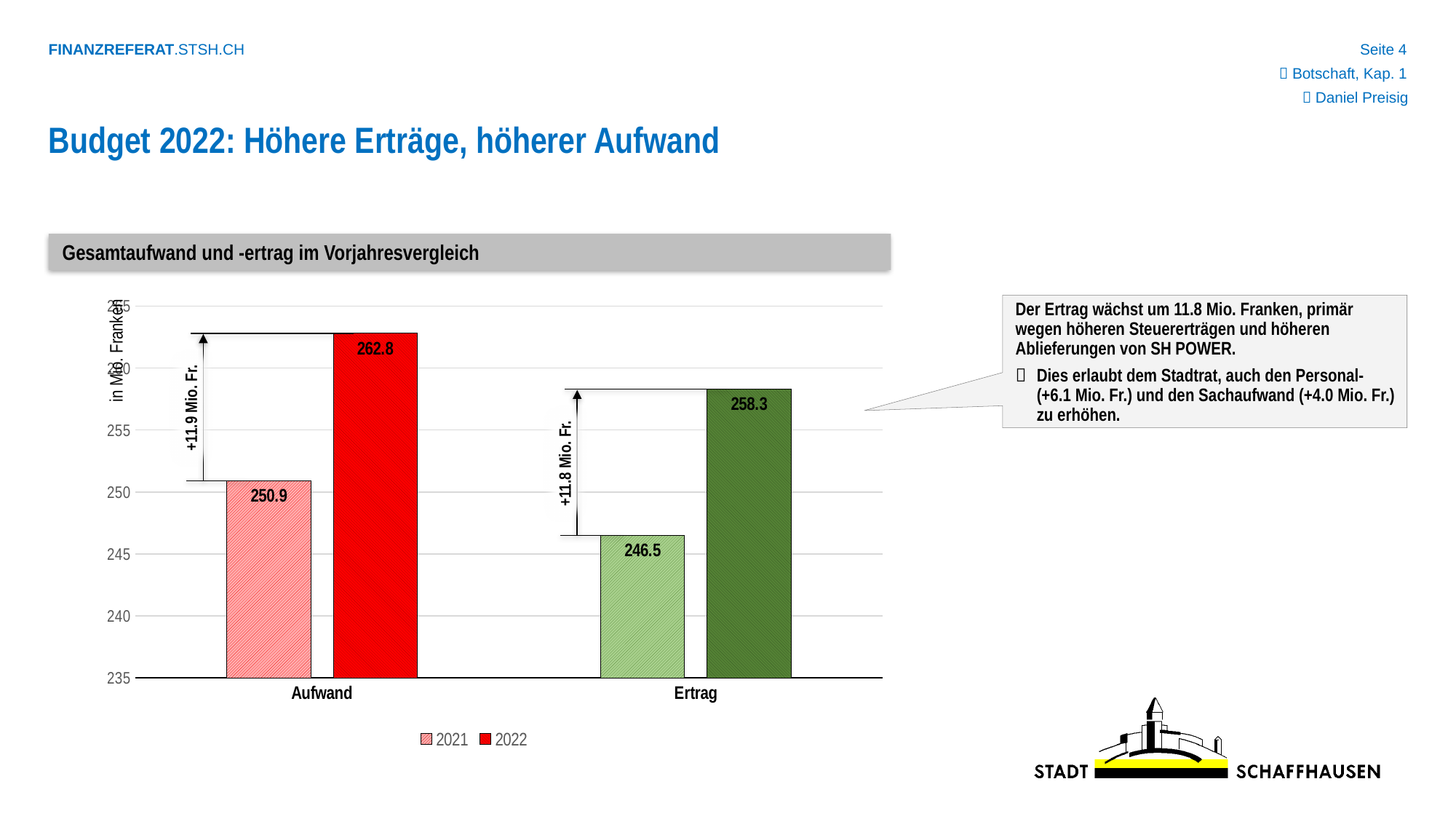
Which is larger, Aufwand 2022 or Ertrag 2022? Aufwand 2022 What is the difference between Ertrag 2022 and Ertrag 2021? 11.8 How many series does the legend list? 2 What is the difference between Aufwand 2022 and Aufwand 2021? 11.9 Which bar has the lowest value in the chart? Ertrag 2021 What kind of chart is shown on the slide? Bar chart What is the title of the chart? Gesamtaufwand und -ertrag im Vorjahresvergleich What is the value for Ertrag in 2021? 246.5 What is the value for Ertrag in 2022? 258.3 Which bar has the highest value in the chart? Aufwand 2022 What is the value for Aufwand in 2022? 262.8 What is the value for Aufwand in 2021? 250.9